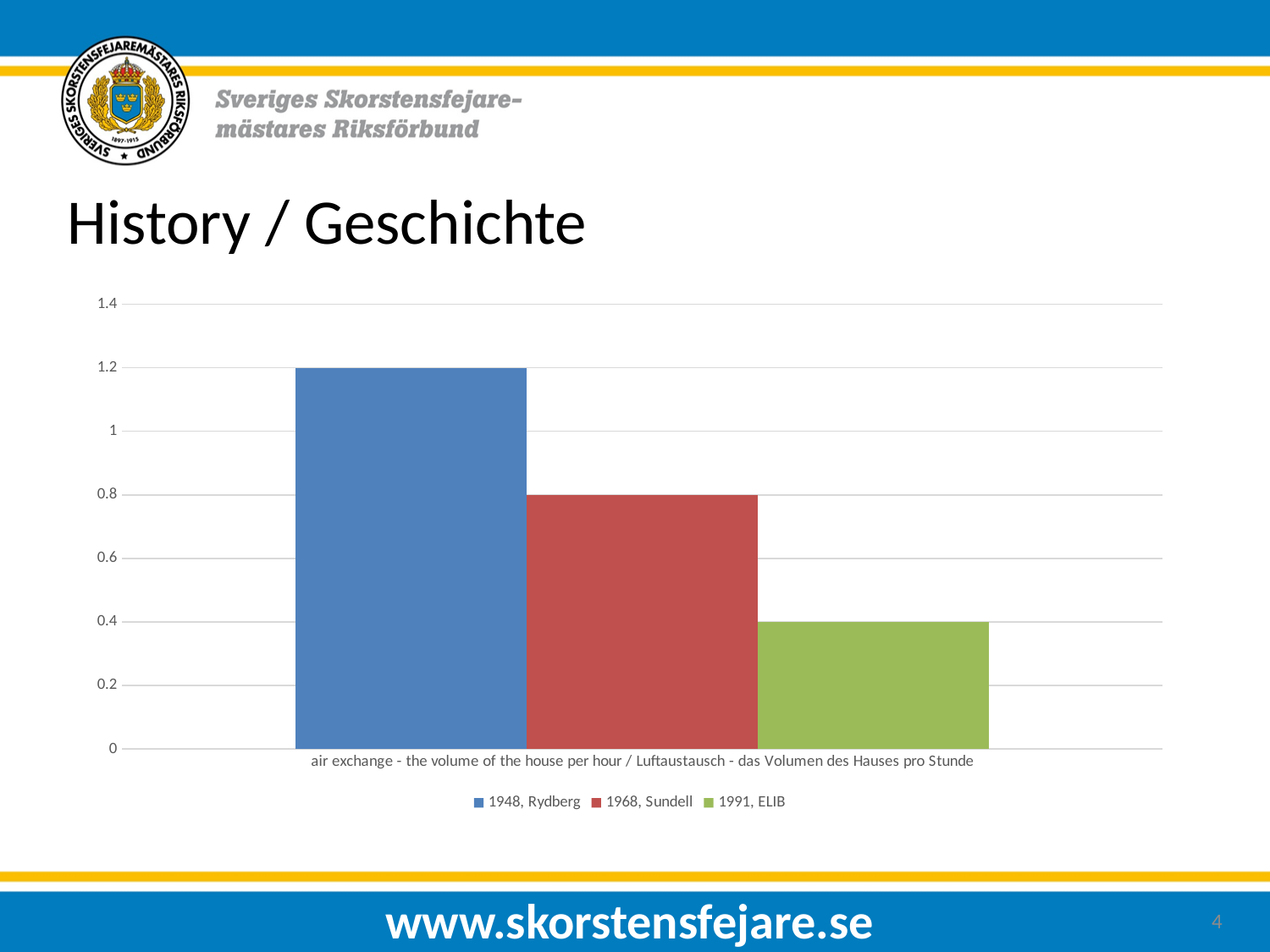
Which is larger, the value for 1968, Sundell or the value for 1991, ELIB? 1968, Sundell What is the difference between the values for 1948, Rydberg and 1991, ELIB? 0.8 What is the value for 1991, ELIB? 0.4 What is the value for 1948, Rydberg? 1.2 What kind of chart is shown on the slide? bar chart Which series has the highest value? 1948, Rydberg Is the value for 1948, Rydberg greater or less than 1? greater How many series does the legend list? 3 Which series has the lowest value? 1991, ELIB What is the value for 1968, Sundell? 0.8 Do the values rise or fall from the 1948 series to the 1991 series? fall What is the label on the x axis of the chart? air exchange - the volume of the house per hour / Luftaustausch - das Volumen des Hauses pro Stunde